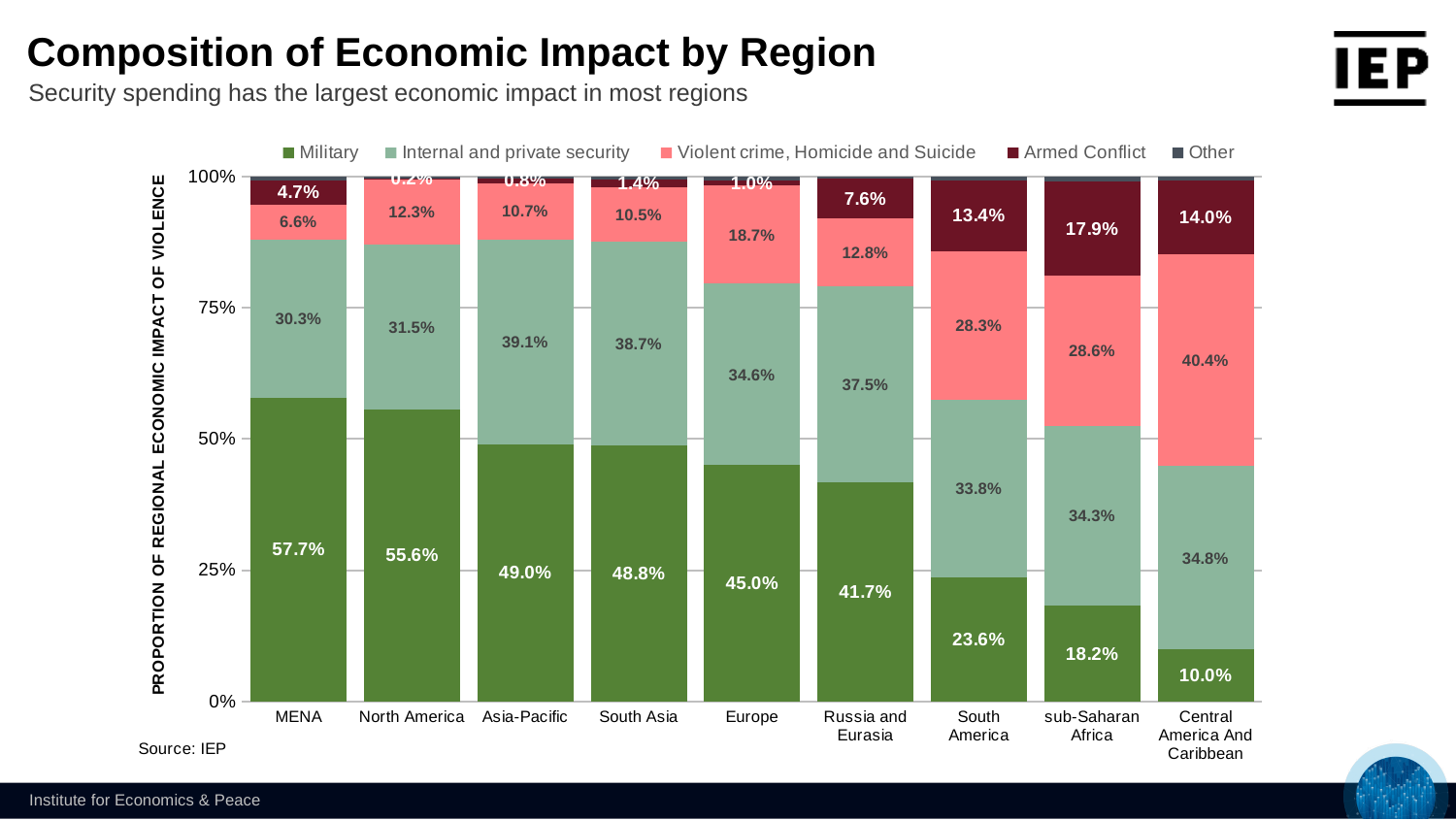
Which region has the highest Military share? MENA How many regions are shown on the x axis? 9 What is the Military share for MENA? 57.7% How many series does the legend list? 5 What kind of chart is shown on the slide? Stacked bar chart Which region has the lowest Military share? Central America And Caribbean What is the Armed Conflict share for sub-Saharan Africa? 17.9% What is the difference between the Military share for MENA and for North America? 2.1 percentage points What is the Internal and private security share for Asia-Pacific? 39.1% Which is larger: the Violent crime, Homicide and Suicide share for Europe or for Russia and Eurasia? Europe What is the Violent crime, Homicide and Suicide share for Central America And Caribbean? 40.4% Which region has the highest Armed Conflict share? sub-Saharan Africa